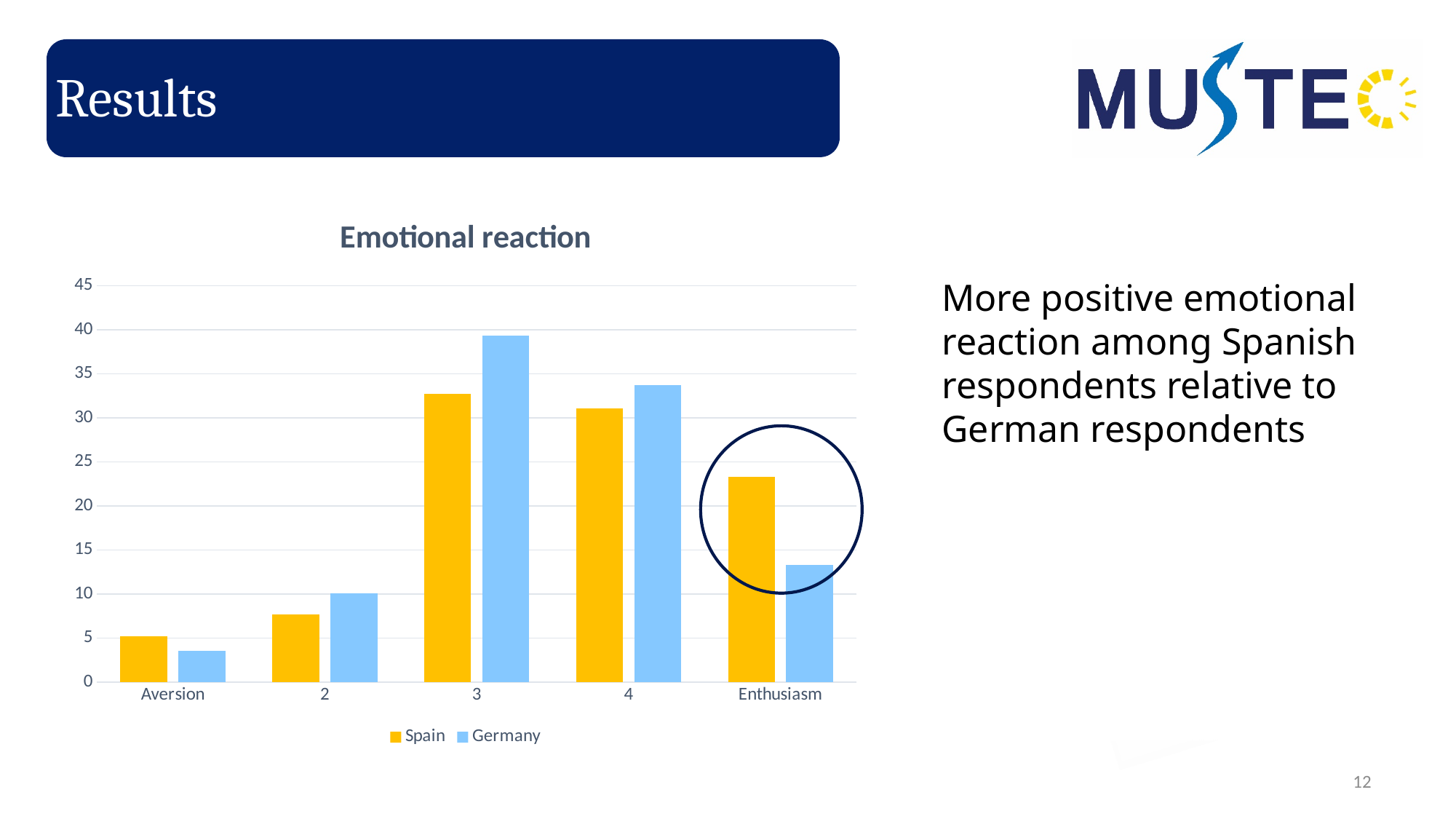
Is the value for Germany in the Enthusiasm category greater or less than 15? less Which category has the lowest value for Germany in the "Emotional reaction" chart? Aversion Which category has the highest value for Germany in the "Emotional reaction" chart? 3 What kind of chart is shown under the title "Emotional reaction"? bar chart Which colour represents Spain in the "Emotional reaction" chart? yellow Is the value for Spain in the Enthusiasm category greater or less than 20? greater For category 3, which series has the larger value, Spain or Germany? Germany Is the value for Germany in category 3 greater or less than 35? greater How many categories are shown on the x axis of the "Emotional reaction" chart? 5 For the Enthusiasm category, which series has the larger value, Spain or Germany? Spain Which category has the lowest value for Spain in the "Emotional reaction" chart? Aversion How many series does the legend of the "Emotional reaction" chart list? 2